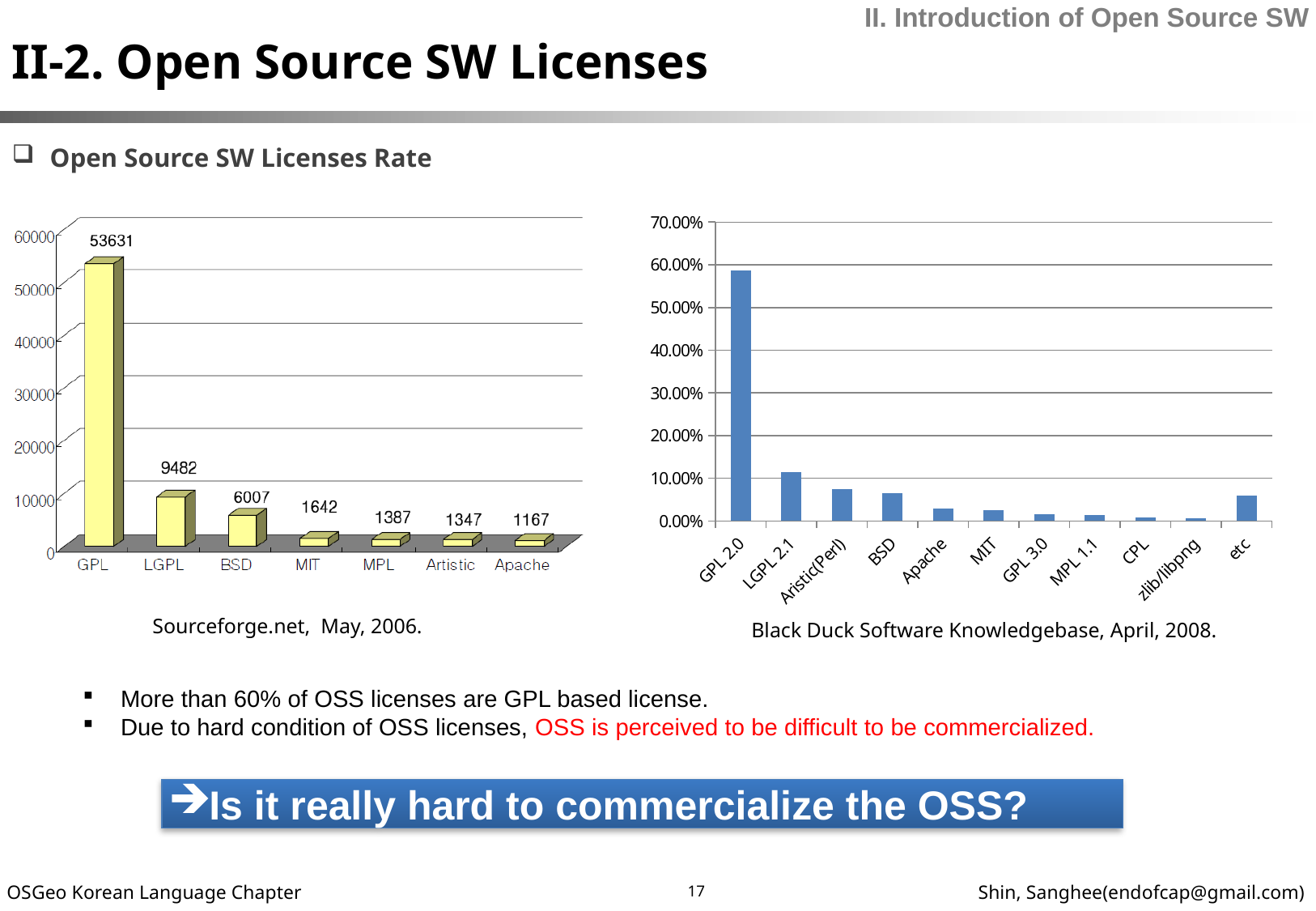
In the left chart (Sourceforge.net, May, 2006), what is the difference between the values for GPL and LGPL? 44149 In the left chart (Sourceforge.net, May, 2006), what is the value for GPL? 53631 In the left chart (Sourceforge.net, May, 2006), which is larger, the value for BSD or the value for MIT? BSD What kind of chart is the right chart (Black Duck Software Knowledgebase, April, 2008)? Bar chart In the right chart (Black Duck Software Knowledgebase, April, 2008), is the value for GPL 2.0 greater or less than 50.00%? greater In the left chart (Sourceforge.net, May, 2006), what is the value for LGPL? 9482 In the left chart (Sourceforge.net, May, 2006), which license has the lowest value? Apache In the left chart (Sourceforge.net, May, 2006), what is the value for Apache? 1167 How many categories are shown in the right chart (Black Duck Software Knowledgebase, April, 2008)? 11 How many licenses are shown in the left chart (Sourceforge.net, May, 2006)? 7 In the left chart (Sourceforge.net, May, 2006), which license has the highest value? GPL In the right chart (Black Duck Software Knowledgebase, April, 2008), which category has the highest value? GPL 2.0